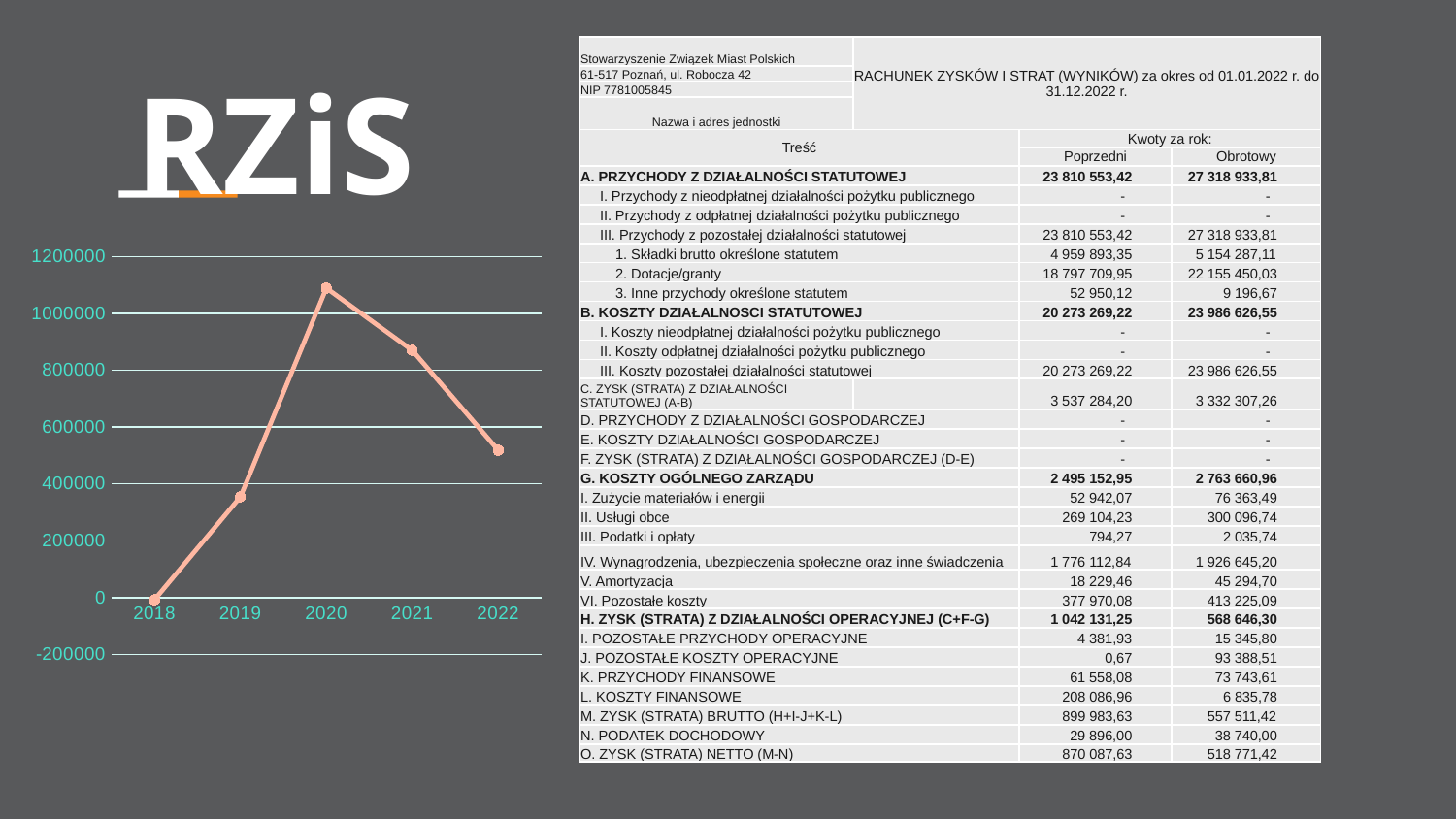
Is the value for 2021 in the line chart greater or less than 800000? greater Which year has the lowest value in the line chart? 2018 What is the lowest tick label shown on the y axis of the line chart? -200000 How many years are plotted on the x axis of the line chart? 5 Which year has the highest value in the line chart? 2020 Is the value for 2018 in the line chart greater or less than 200000? less How does the line chart's value change from 2020 to 2022? it falls In the line chart, which year has the larger value, 2021 or 2022? 2021 Is the value for 2019 in the line chart greater or less than 400000? less What kind of chart is shown on the left of the slide? line chart